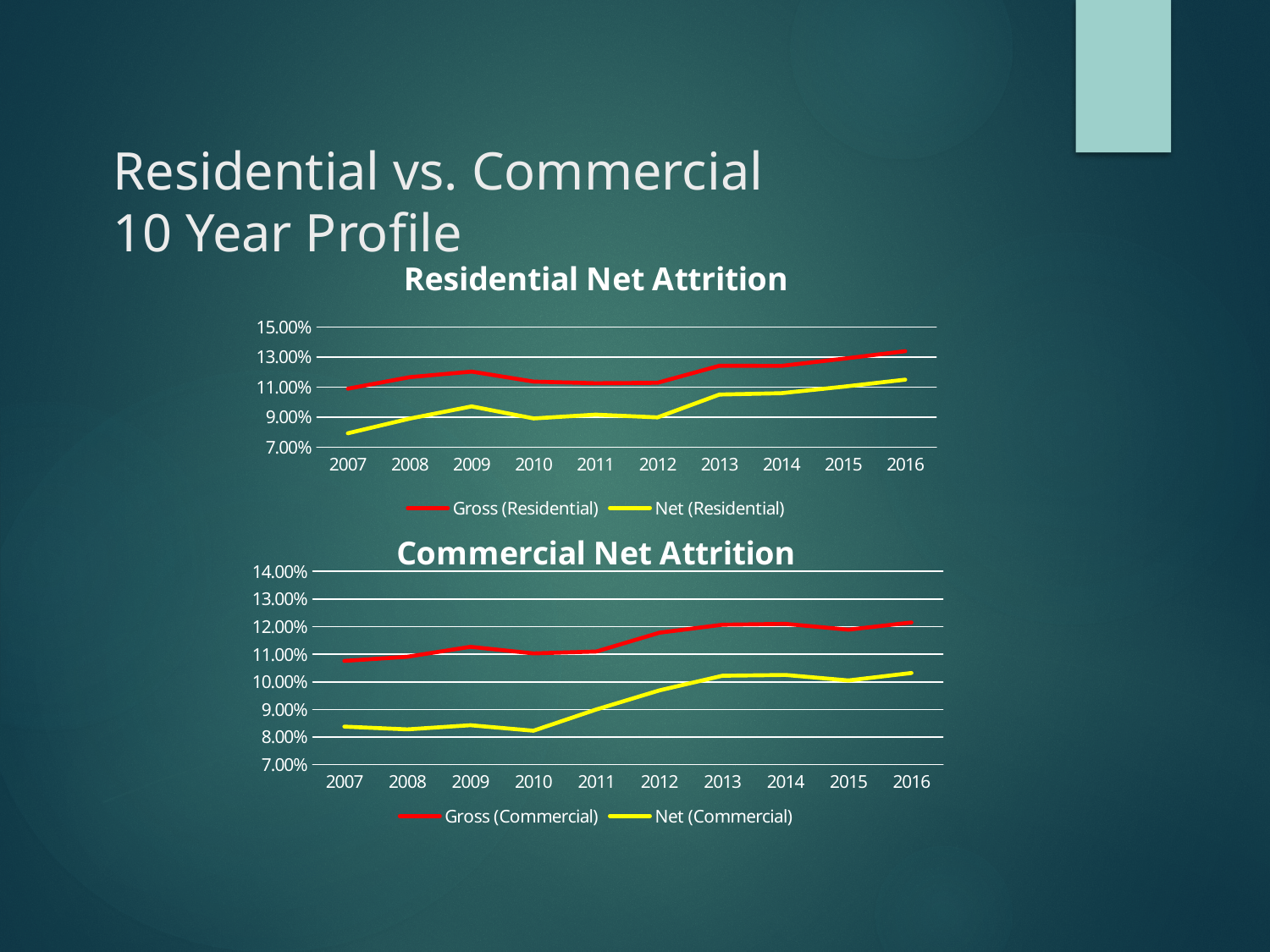
In the Residential Net Attrition chart, which year has the lowest Net (Residential) value? 2007 How many series does the legend of the Commercial Net Attrition chart list? 2 In the Commercial Net Attrition chart, is the Net (Commercial) value for 2010 greater or less than 9.00%? less In the Residential Net Attrition chart, does the Gross (Residential) line generally rise or fall from 2007 to 2016? rise In the Commercial Net Attrition chart, which is larger in 2016, Gross (Commercial) or Net (Commercial)? Gross (Commercial) What colour is the Net (Residential) line in the Residential Net Attrition chart? yellow In the Commercial Net Attrition chart, is the Net (Commercial) value for 2013 greater or less than 10.00%? greater In the Residential Net Attrition chart, is the Gross (Residential) value for 2016 greater or less than 13.00%? greater What type of chart is the Residential Net Attrition chart? line chart How many years are shown on the x axis of the Residential Net Attrition chart? 10 In the Commercial Net Attrition chart, does the Net (Commercial) line generally rise or fall from 2010 to 2016? rise